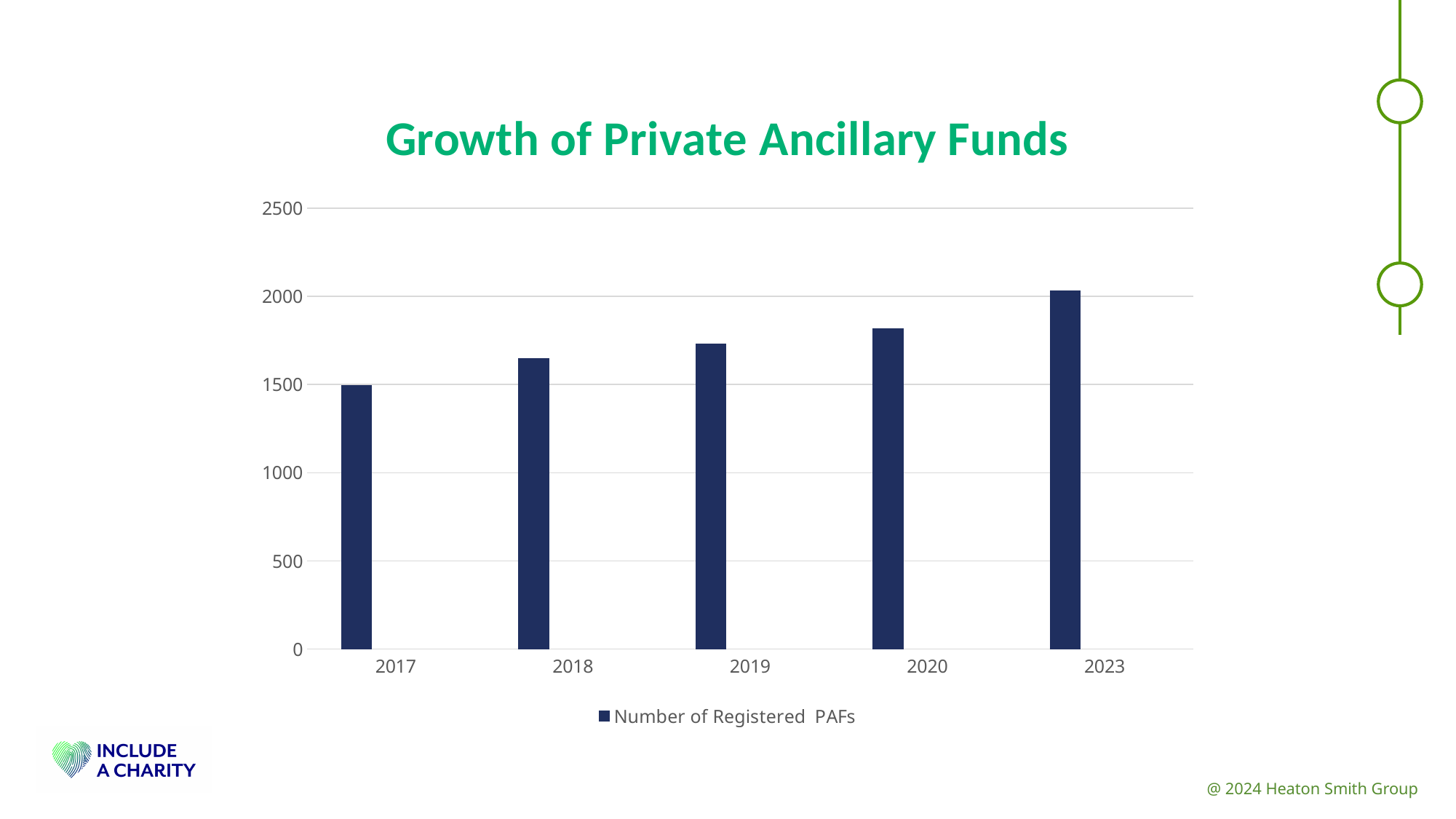
Is the value for 2019 greater or less than 2000? less What kind of chart is shown on the slide? bar chart How many series does the legend list? 1 Which year has the highest number of registered PAFs? 2023 Is the value for 2018 greater or less than 1500? greater Which year has more registered PAFs, 2018 or 2020? 2020 What series does the legend list? Number of Registered PAFs How many years are shown on the x axis? 5 Which year has the lowest number of registered PAFs? 2017 Do the values rise or fall from 2017 to 2023? rise What is the title of the chart? Growth of Private Ancillary Funds Is the value for 2020 greater or less than 2000? less